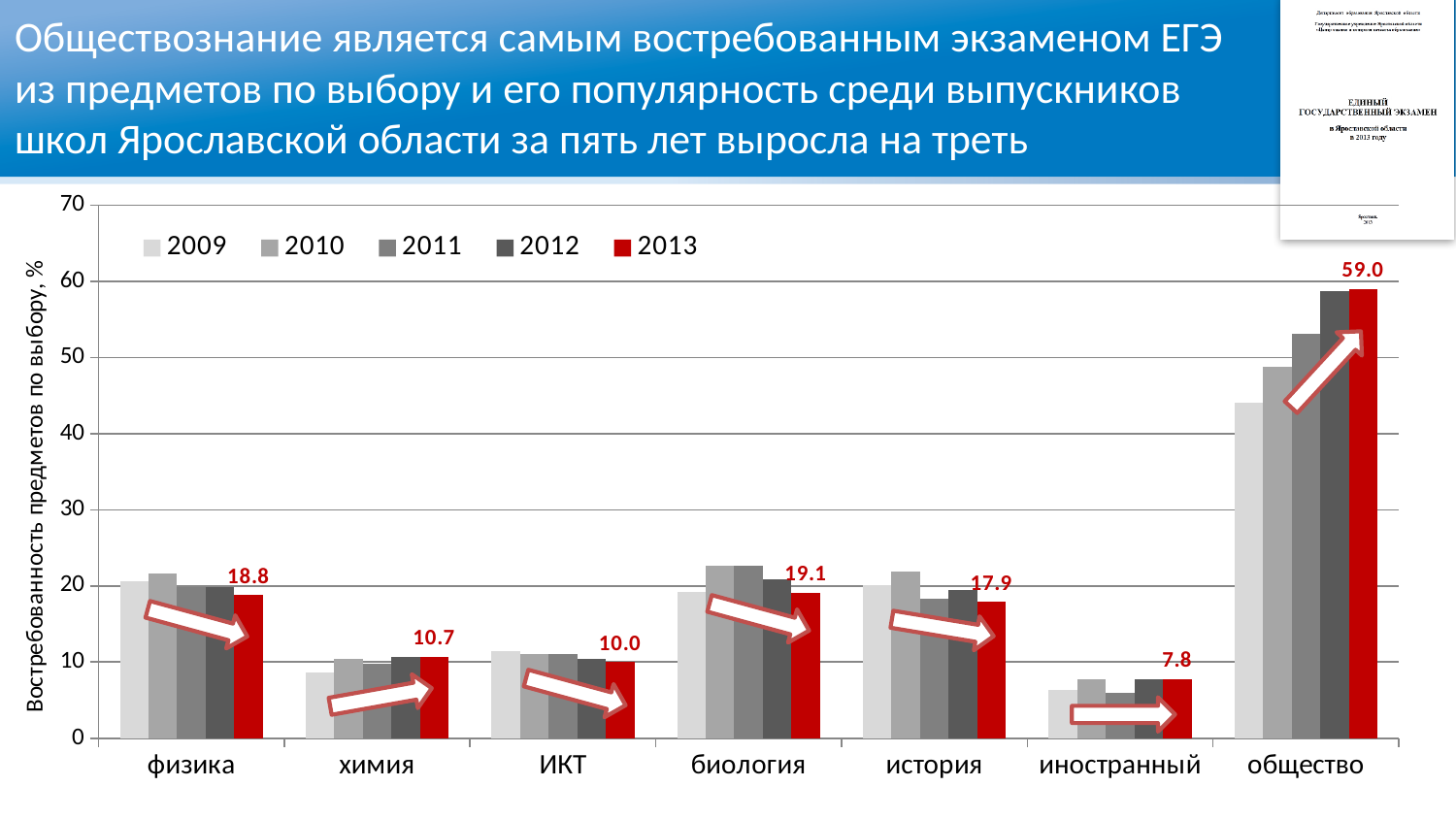
Which subject has the lowest value in 2013? иностранный What is the value for общество in 2013? 59.0 Which is larger in 2013: химия or ИКТ? химия Is the 2009 value for общество greater or less than 40? greater What is the value for ИКТ in 2013? 10.0 How many series does the legend list? 5 What is the value for физика in 2013? 18.8 What kind of chart is shown on the slide? bar chart What is the difference between the 2013 values for биология and история? 1.2 What is the value for иностранный in 2013? 7.8 How many subjects are shown on the x axis? 7 Which subject has the highest value in 2013? общество